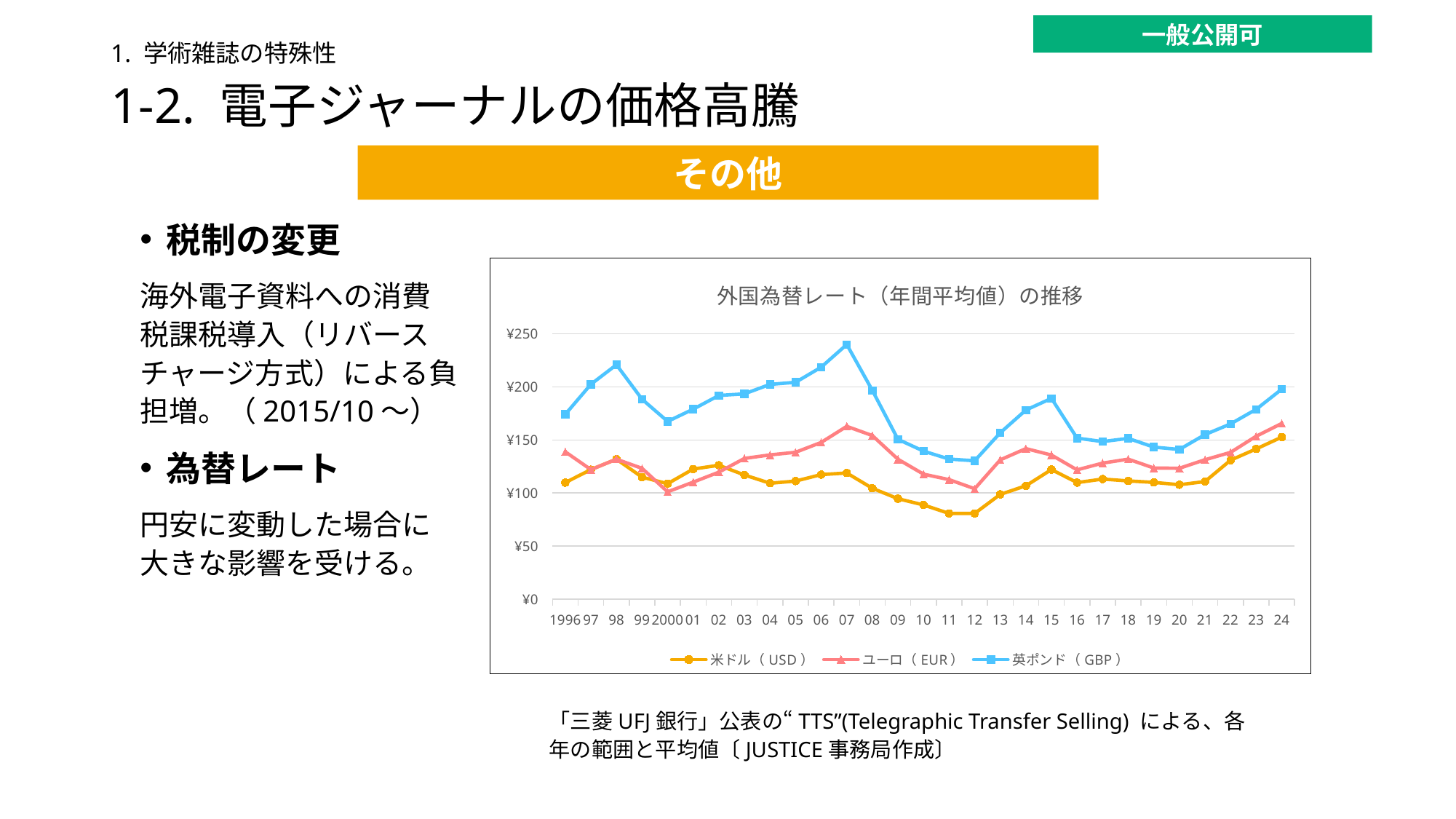
How many series does the chart legend list? 3 In which year does the 英ポンド（GBP） series reach its highest value? 2007 Is the value for 英ポンド（GBP） in 2007 greater or less than ¥200? greater What kind of chart is shown on the slide? line chart Is the value for ユーロ（EUR） in 2012 greater or less than ¥150? less Does the 米ドル（USD） series rise or fall from 2007 to 2011? fall How many years are plotted along the x axis of the chart? 29 In 2012, which is larger: the value for ユーロ（EUR） or the value for 米ドル（USD）? ユーロ（EUR） Is the value for 米ドル（USD） in 2011 greater or less than ¥100? less In which year does the 米ドル（USD） series reach its highest value? 2024 What is the title of the chart? 外国為替レート（年間平均値）の推移 Which currency series is drawn in blue in the chart? 英ポンド（GBP）